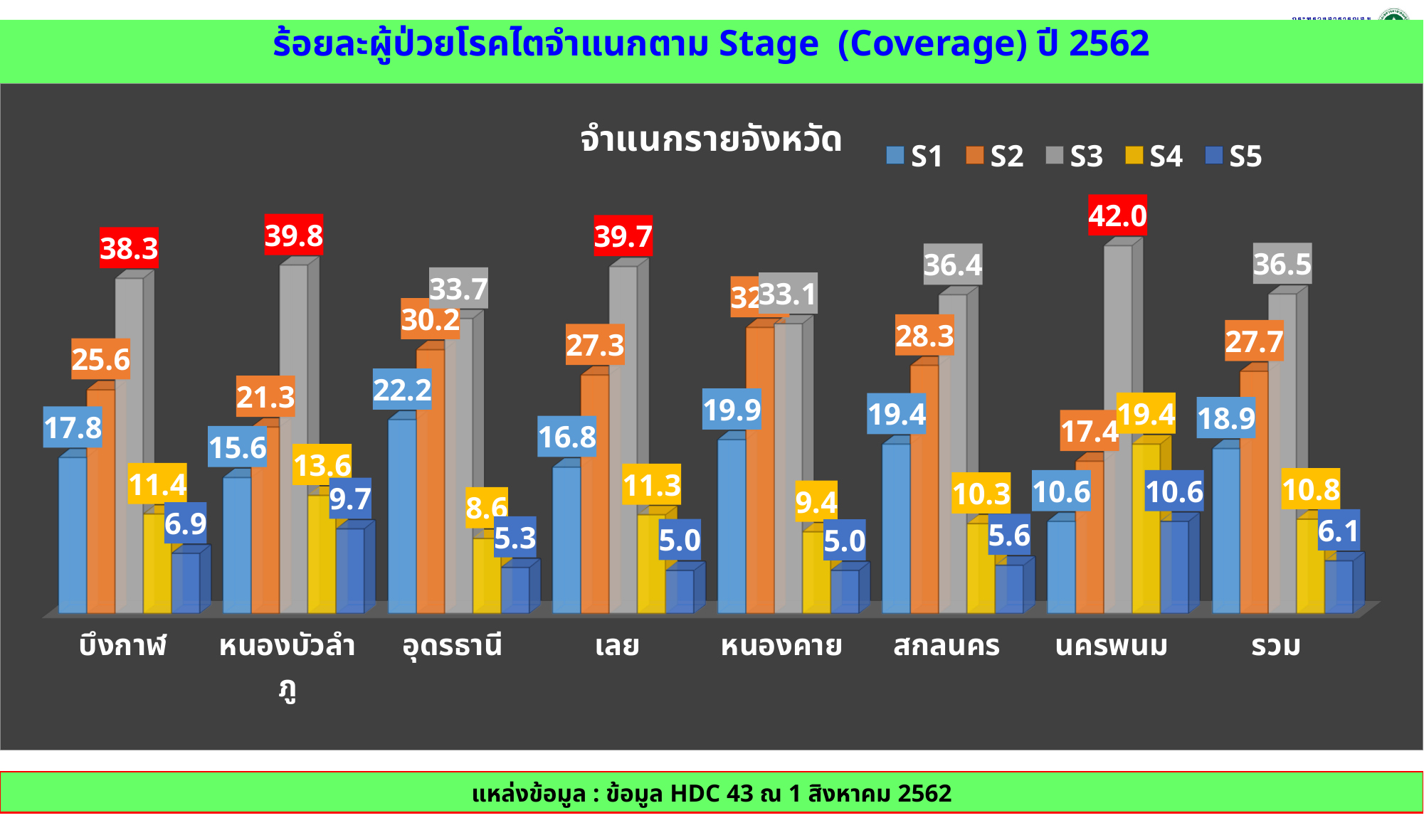
How many series does the legend list? 5 How many categories are shown on the x axis? 8 What is the S1 value for อุดรธานี? 22.2 What is the difference between the S3 and S1 values for บึงกาฬ? 20.5 What kind of chart is shown on the slide? Bar chart What is the S4 value for รวม? 10.8 What is the S3 value for นครพนม? 42.0 What is the S5 value for หนองบัวลำภู? 9.7 Which province has the highest S3 value? นครพนม What colour are the S3 bars? Grey Which is larger for สกลนคร, the S2 value or the S4 value? S2 Which category has the lowest S1 value? นครพนม